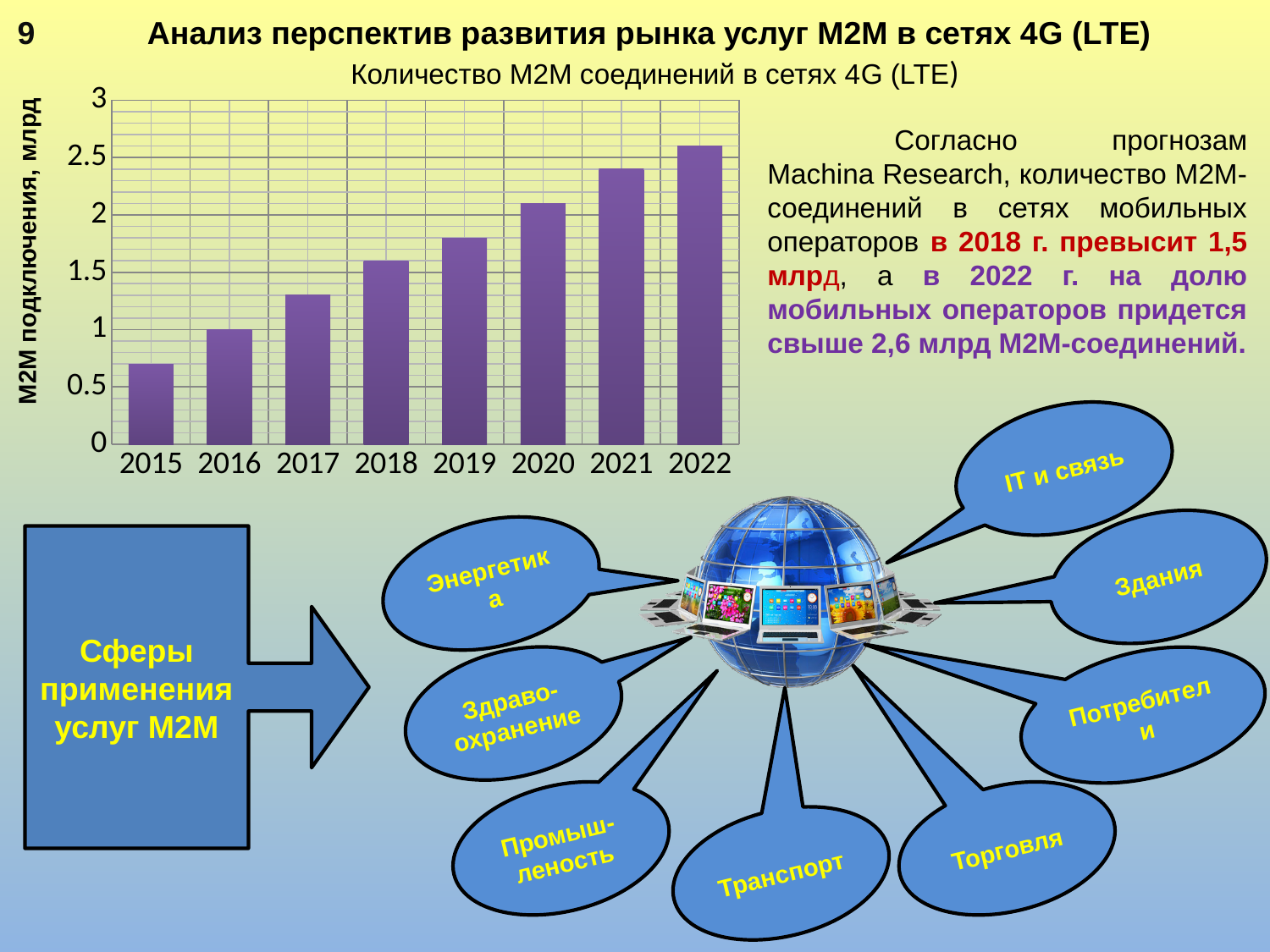
Is the value for 2019 greater or less than 2? less Which year has the lowest value in the chart? 2015 How many years are shown on the x axis of the chart? 8 Which year has the highest value in the chart? 2022 Is the value for 2018 greater or less than 1.5? greater What is the label of the vertical axis of the chart? М2М подключения, млрд Do the values rise or fall from 2015 to 2022? Rise Is the value for 2022 greater or less than 2.5? greater What is the title of the chart? Количество М2М соединений в сетях 4G (LTE) What kind of chart is shown on the slide? Bar chart Which is larger, the value for 2017 or the value for 2020? 2020